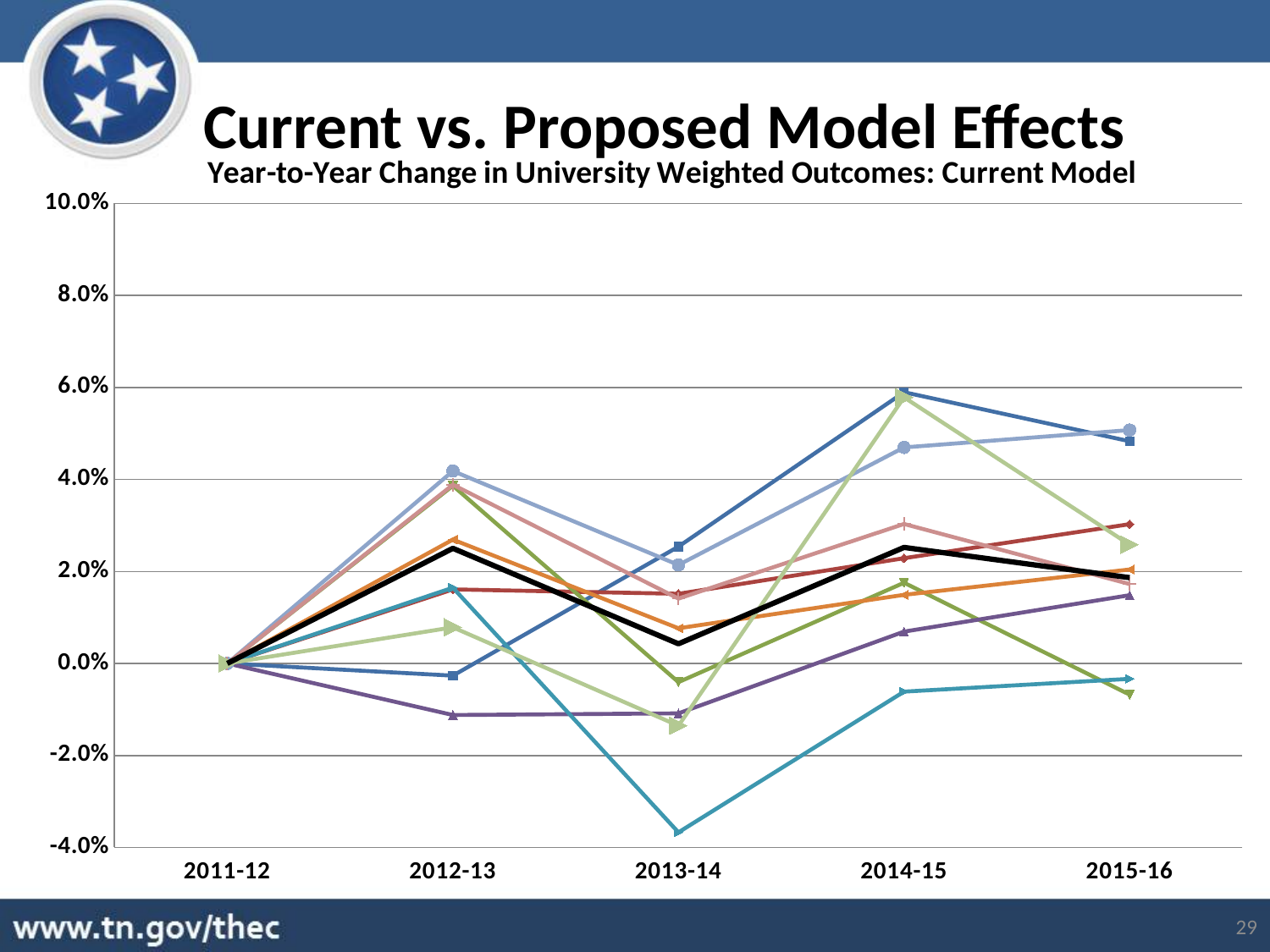
What kind of chart is shown on the slide? line chart What is the last academic year shown on the x axis? 2015-16 What value do all the lines share at 2011-12? 0.0% How many academic years are shown along the x axis of the chart? 5 What is the title of the chart? Year-to-Year Change in University Weighted Outcomes: Current Model What is the highest value shown on the y axis of the chart? 10.0% What is the first academic year shown on the x axis? 2011-12